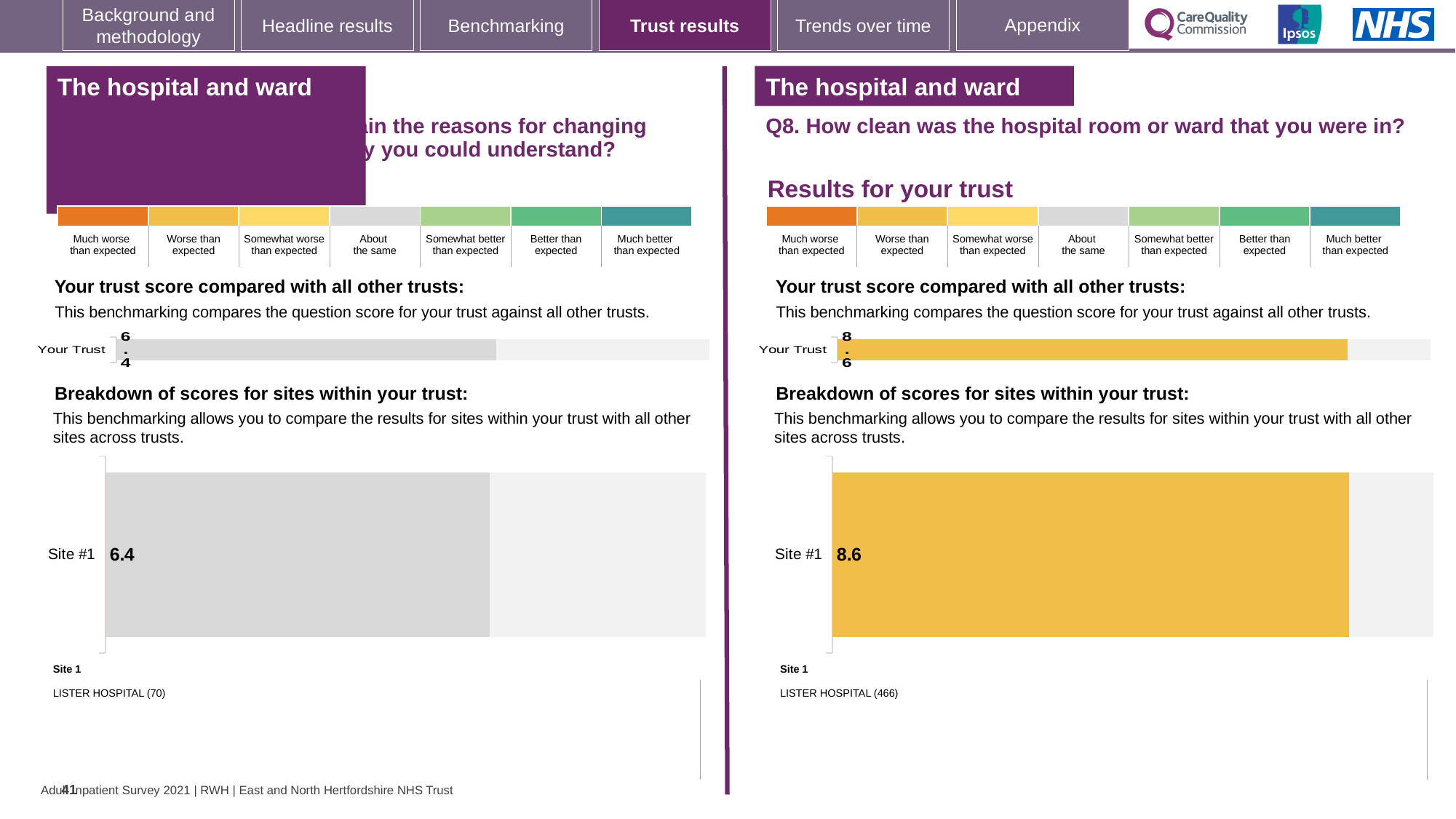
On the left-hand side of the slide, what is the 'Your Trust' score shown in the trust comparison bar? 6.4 On the right-hand side of the slide (Q8, how clean was the hospital room or ward), what is the 'Your Trust' score? 8.6 Which is larger: the Site #1 score in the left-hand breakdown chart or the Site #1 score in the right-hand breakdown chart (Q8)? The right-hand chart (Q8) What is the difference between the Site #1 score in the right-hand breakdown chart (Q8) and the Site #1 score in the left-hand breakdown chart? 2.2 Is the Site #1 score in the left-hand breakdown chart greater or less than 7? less How many sites are shown in the right-hand 'Breakdown of scores for sites within your trust' chart (Q8)? 1 In the right-hand 'Breakdown of scores for sites within your trust' chart (Q8), what is the score for Site #1? 8.6 In the right-hand breakdown chart (Q8), which site is listed as Site 1? LISTER HOSPITAL (466) What type of chart is used for the 'Breakdown of scores for sites within your trust' on the right-hand side (Q8)? Bar chart In the left-hand breakdown chart, which site is listed as Site 1? LISTER HOSPITAL (70) Is the 'Your Trust' score on the right-hand side (Q8) greater or less than 8? greater In the left-hand 'Breakdown of scores for sites within your trust' chart, what is the score for Site #1? 6.4